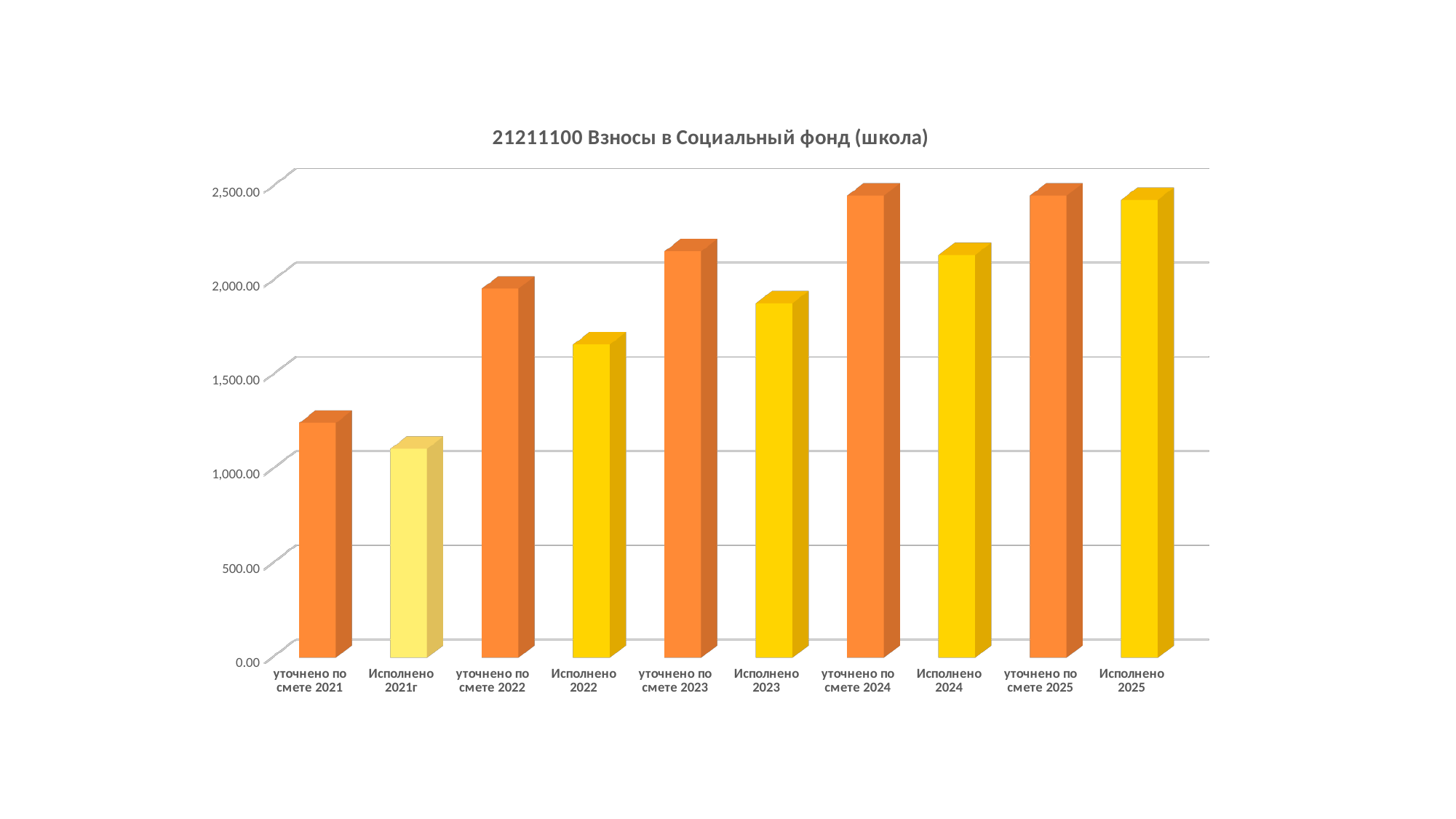
Is the value for уточнено по смете 2021 greater or less than 1,000.00? greater Is the value for Исполнено 2022 greater or less than 1,500.00? greater What is the title of the chart? 21211100 Взносы в Социальный фонд (школа) Is the value for Исполнено 2023 greater or less than 2,000.00? less Which category has the lowest value in the chart? Исполнено 2021г Which is larger: the value for Исполнено 2022 or the value for Исполнено 2023? Исполнено 2023 Do the Исполнено values rise or fall from 2021 to 2025? rise What type of chart is shown on the slide? Bar chart How many bars (categories) are shown in the chart? 10